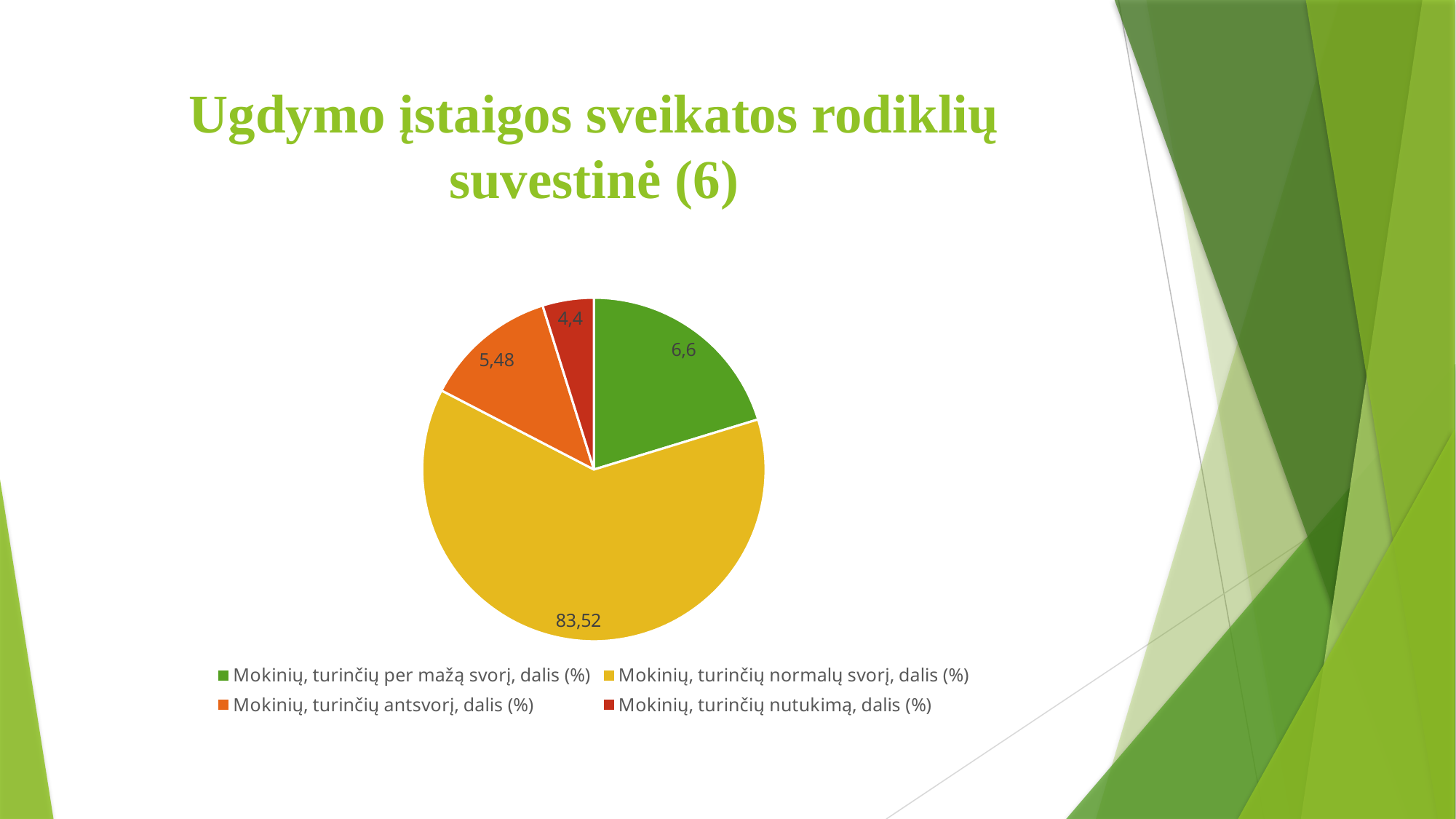
How many slices does the pie chart have? 4 What is the value for "Mokinių, turinčių antsvorį, dalis (%)"? 5,48 What is the value for "Mokinių, turinčių nutukimą, dalis (%)"? 4,4 Which category has the largest slice of the pie? Mokinių, turinčių normalų svorį, dalis (%) What is the difference between the values for "Mokinių, turinčių antsvorį" and "Mokinių, turinčių nutukimą"? 1,08 What kind of chart is shown on the slide? pie chart What is the value for "Mokinių, turinčių normalų svorį, dalis (%)"? 83,52 Which category has the smallest slice of the pie? Mokinių, turinčių nutukimą, dalis (%) What is the value for "Mokinių, turinčių per mažą svorį, dalis (%)"? 6,6 What is the difference between the values for "Mokinių, turinčių normalų svorį" and "Mokinių, turinčių per mažą svorį"? 76,92 Which is larger: the value for "Mokinių, turinčių per mažą svorį" or "Mokinių, turinčių antsvorį"? Mokinių, turinčių per mažą svorį What colour is the slice for "Mokinių, turinčių nutukimą, dalis (%)"? red